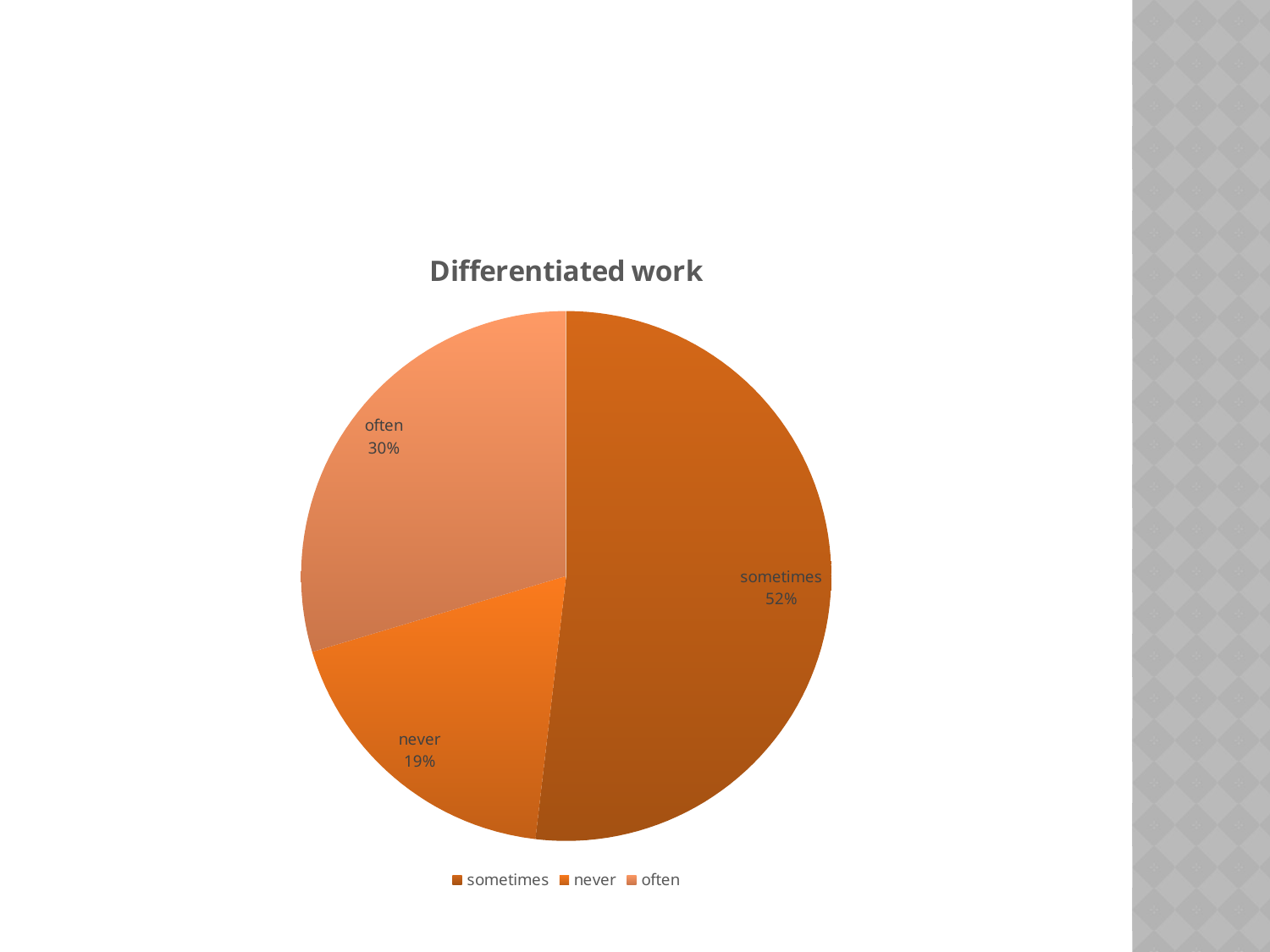
What percentage of the pie is labelled "often"? 30% Which category has the largest share of the pie? sometimes Which category has the smallest share of the pie? never What is the difference in percentage points between the "often" and "never" slices? 11 What is the title of the chart? Differentiated work Which slice is larger, "often" or "never"? often How many entries does the legend list? 3 What kind of chart is shown on the slide? pie chart What percentage of the pie is labelled "sometimes"? 52% What is the difference in percentage points between the "sometimes" and "often" slices? 22 How many slices does the pie chart have? 3 What percentage of the pie is labelled "never"? 19%